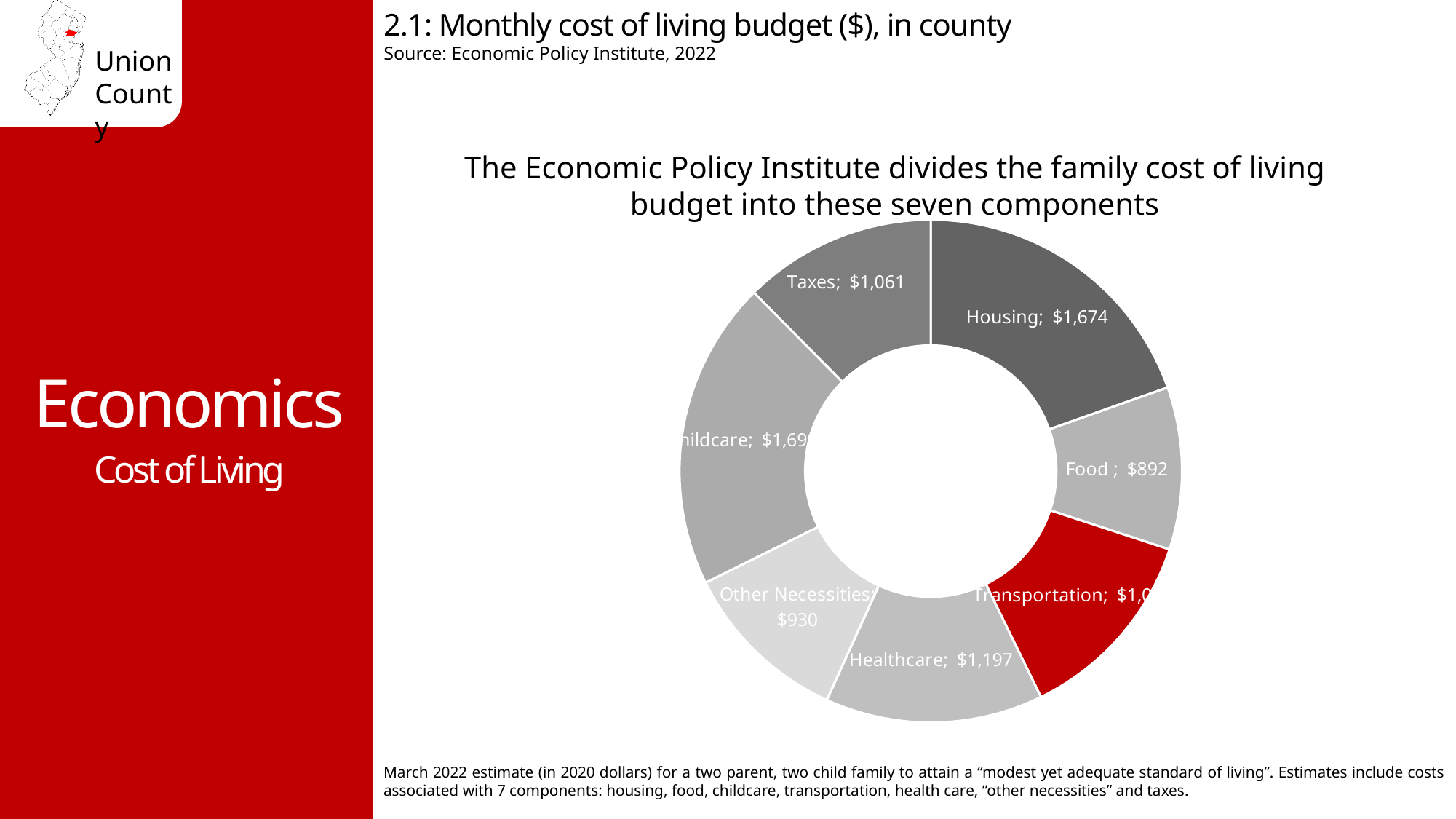
What is the difference between the Housing and Food monthly costs? $782 What is the source cited for the chart? Economic Policy Institute, 2022 What is the monthly cost for Housing in the chart? $1,674 What is the monthly cost for Other Necessities in the chart? $930 What is the monthly cost for Food in the chart? $892 Which component has the lowest monthly cost in the chart? Food What kind of chart is shown on the slide? Pie (donut) chart What is the monthly cost for Healthcare in the chart? $1,197 What is the monthly cost for Taxes in the chart? $1,061 Which is larger, the monthly cost for Healthcare or for Taxes? Healthcare What is the difference between the Healthcare and Taxes monthly costs? $136 How many components does the chart divide the cost of living budget into? 7